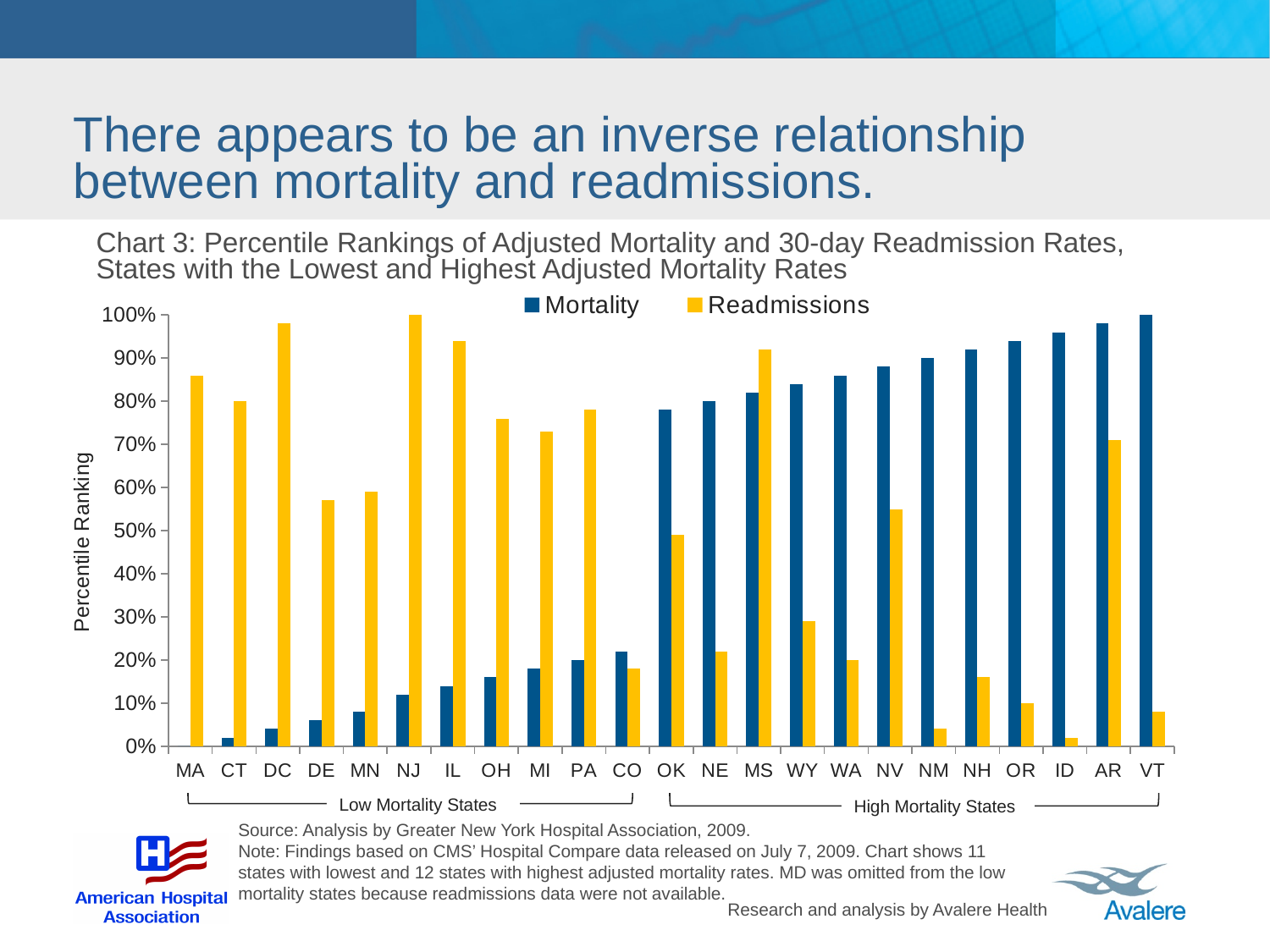
How many states are shown along the x axis? 23 Which state has the highest Mortality percentile ranking? VT Is the Mortality value for CT greater or less than 10%? less Do the Mortality values generally rise or fall moving from left to right along the x axis? rise Which state has the larger Readmissions value, NV or NM? NV Which state has the highest Readmissions percentile ranking? NJ Which is larger for OK, the Mortality value or the Readmissions value? Mortality Is the Readmissions value for NH greater or less than 20%? less Is the Readmissions value for NV greater or less than 50%? greater What kind of chart is shown on the slide? bar chart How many series does the legend list? 2